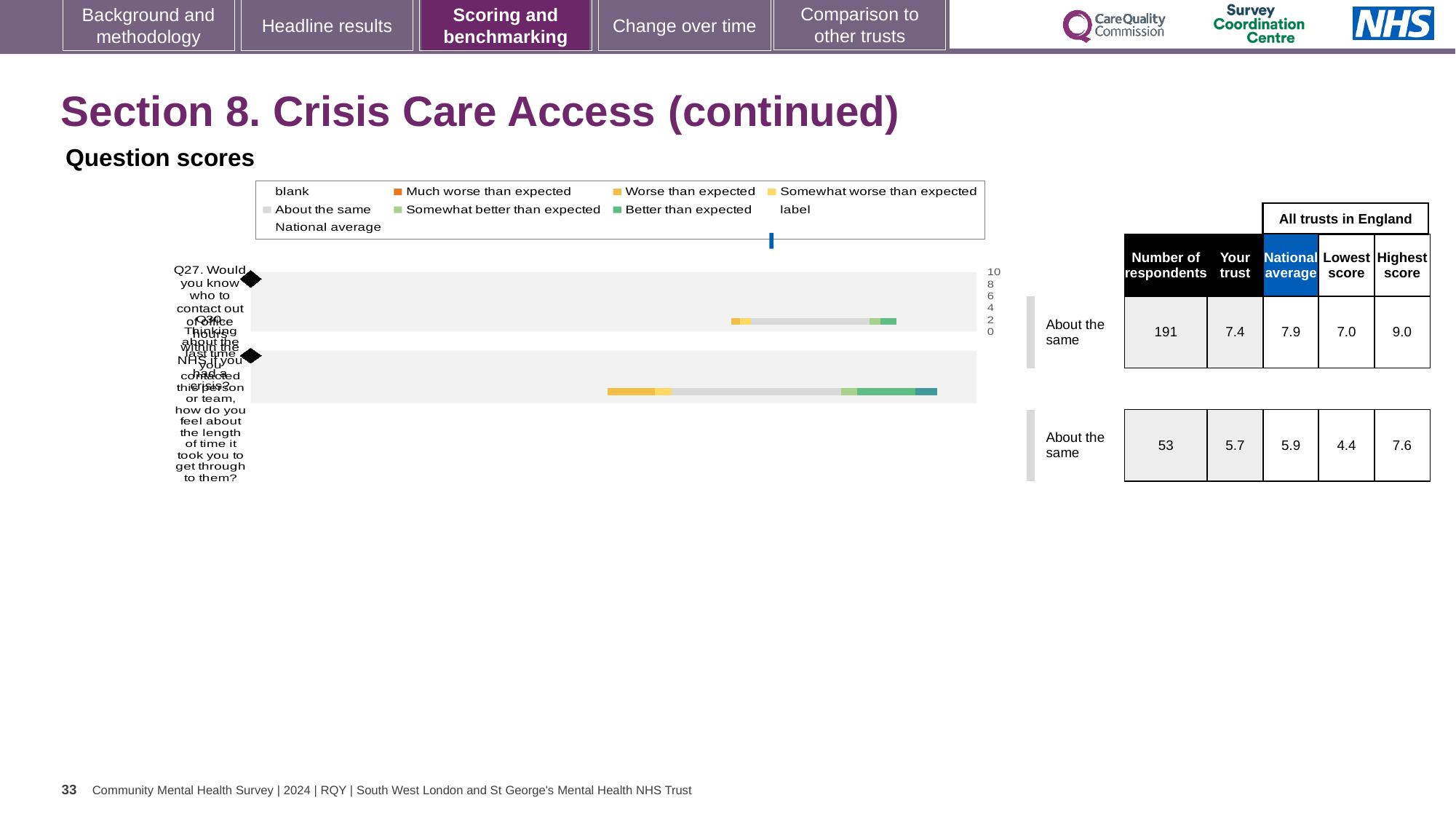
How many respondents answered Q27 according to the table? 191 What is the difference between the national average and the 'Your trust' score for Q27? 0.5 What benchmark category is shown for Q30 in the chart? About the same What is the highest score across all trusts in England for Q30? 7.6 What is the difference between the highest and lowest scores for Q30? 3.2 What is the lowest score across all trusts in England for Q27? 7.0 What kind of chart is shown under 'Question scores'? bar chart What is the maximum value shown on the chart's score axis? 10 What is the national average score for Q30 shown in the table next to the chart? 5.9 Which question has the higher 'Your trust' score, Q27 or Q30? Q27 What is the 'Your trust' score for Q27 shown in the table next to the chart? 7.4 How many questions (bars) are plotted in the Question scores chart? 2